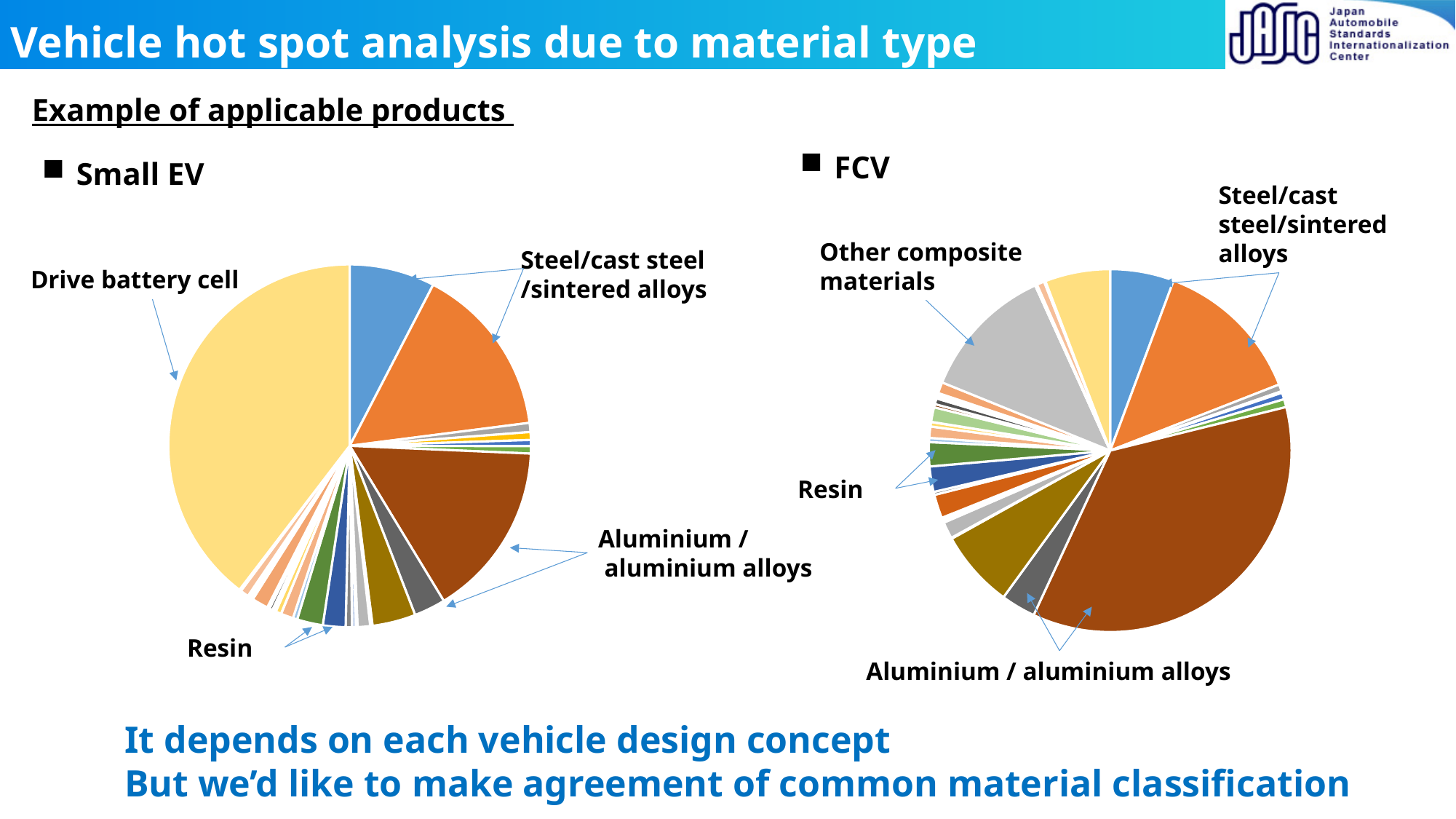
Which chart on the slide has a slice labelled Drive battery cell? Small EV In the Small EV chart, which slice is larger: Aluminium / aluminium alloys or Resin? Aluminium / aluminium alloys In the Small EV chart, which slice is larger: Drive battery cell or Steel/cast steel/sintered alloys? Drive battery cell In the FCV chart, which slice is larger: Aluminium / aluminium alloys or Steel/cast steel/sintered alloys? Aluminium / aluminium alloys In the Small EV chart, which labelled material has the largest slice? Drive battery cell What kind of chart is the FCV chart? Pie chart How many pie charts are shown on the slide? 2 What kind of chart is the Small EV chart? Pie chart In the FCV chart, which labelled material has the largest slice? Aluminium / aluminium alloys Which chart on the slide has a slice labelled Other composite materials? FCV